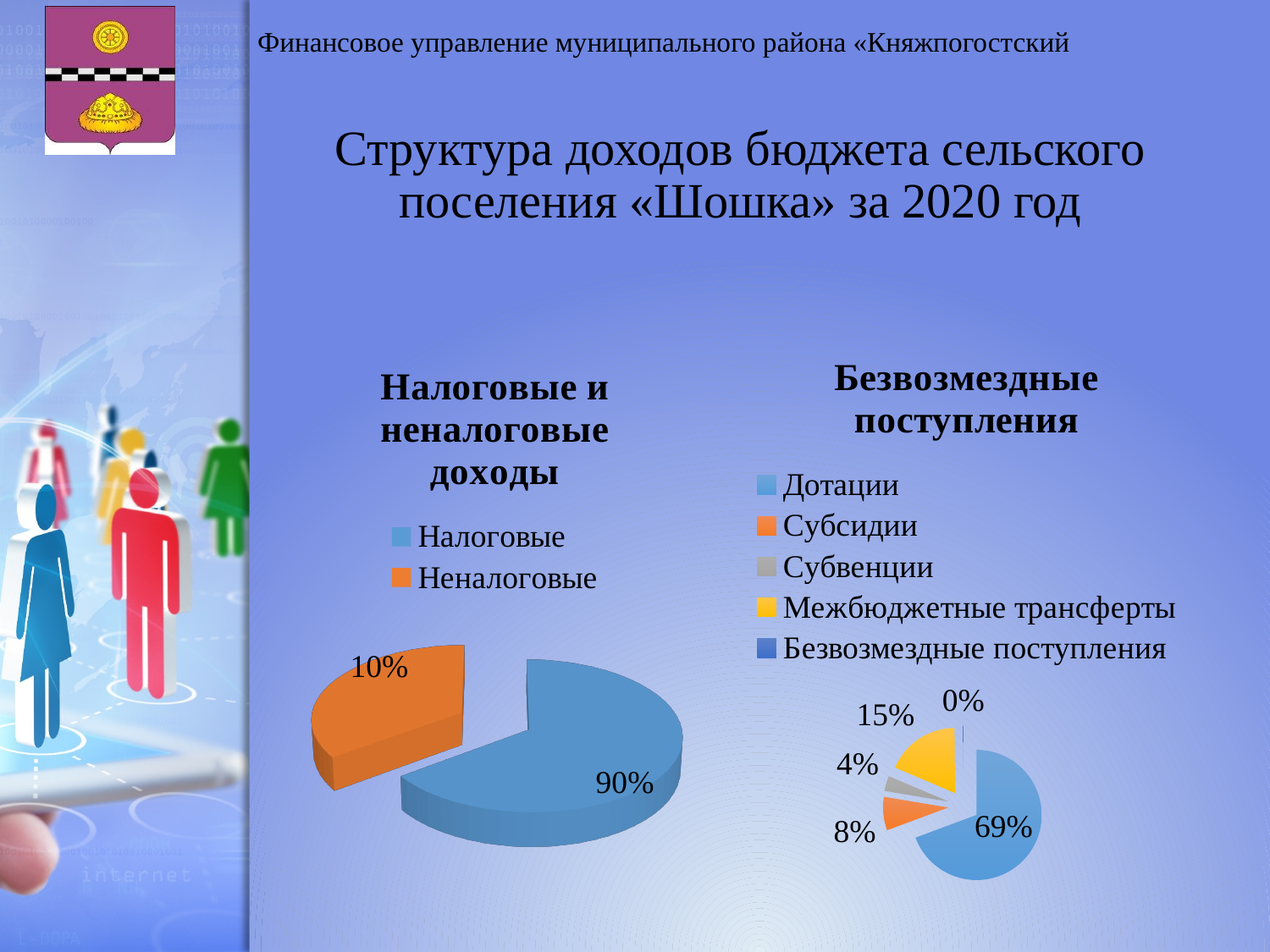
In the chart titled «Безвозмездные поступления», how many categories does the legend list? 5 In the chart titled «Налоговые и неналоговые доходы», how many series does the legend list? 2 In the chart titled «Налоговые и неналоговые доходы», what share is Неналоговые? 10% In the chart titled «Налоговые и неналоговые доходы», what kind of chart is shown? pie chart In the chart titled «Налоговые и неналоговые доходы», what share is Налоговые? 90% In the chart titled «Безвозмездные поступления», what share is Субсидии? 8% In the chart titled «Безвозмездные поступления», which category has the largest share? Дотации In the chart titled «Безвозмездные поступления», what share is Субвенции? 4% In the chart titled «Безвозмездные поступления», what is the difference between the shares of Дотации and Межбюджетные трансферты? 54% In the chart titled «Безвозмездные поступления», what share is Межбюджетные трансферты? 15% In the chart titled «Безвозмездные поступления», what share is Дотации? 69% In the chart titled «Безвозмездные поступления», which is larger, Субсидии or Субвенции? Субсидии